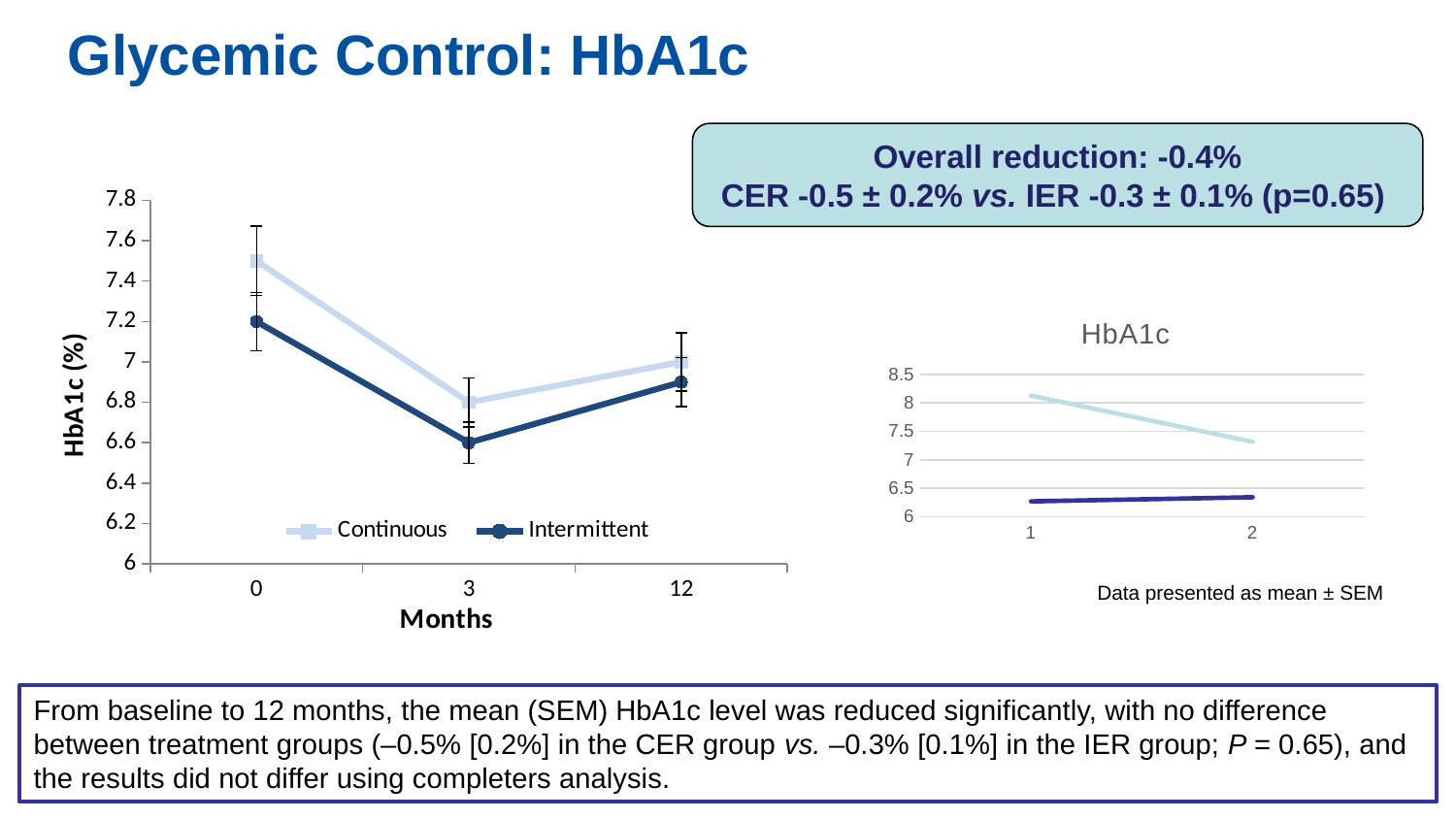
In the left chart (Months on the x axis), how many series does the legend list? 2 In the left chart (Months on the x axis), which series has the higher value at 3 months, Continuous or Intermittent? Continuous In the left chart (Months on the x axis), does the Continuous series rise or fall from 0 to 3 months? fall In the right chart titled HbA1c, does the upper (light) line rise or fall from 1 to 2? fall In the right chart titled HbA1c, is the value of the upper (light) line at x = 1 greater or less than 8? greater In the left chart (Months on the x axis), is the Continuous value at 0 months greater or less than 7.4? greater In the left chart (Months on the x axis), what are the two legend entries? Continuous and Intermittent What kind of chart is the left chart with the x axis labelled Months? line chart In the left chart (Months on the x axis), is the Intermittent value at 3 months greater or less than 6.8? less In the left chart (Months on the x axis), how many time points are plotted along the x axis? 3 What is the title of the small chart on the right? HbA1c In the left chart (Months on the x axis), at which month is the Intermittent series at its lowest? 3